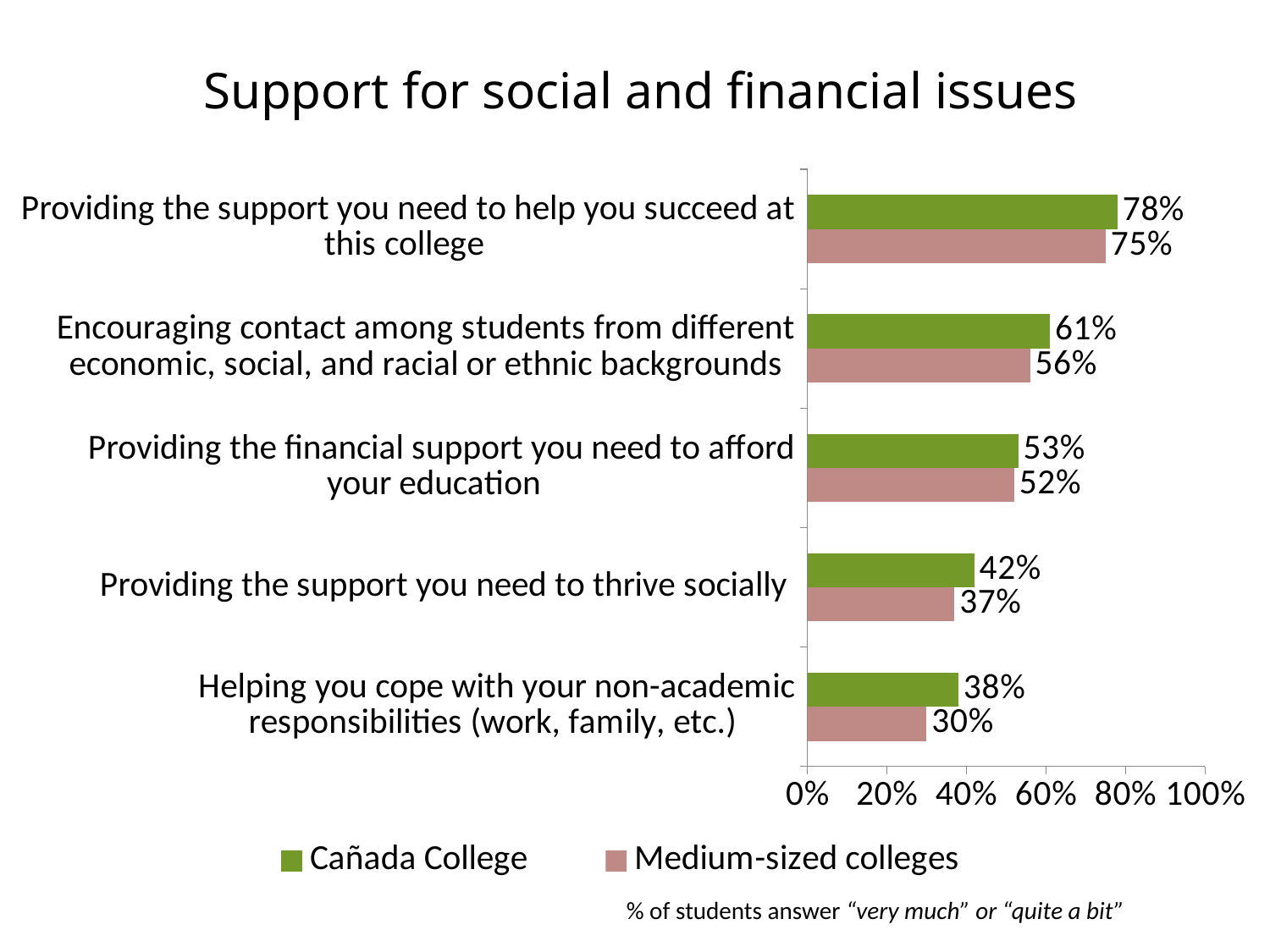
For "Providing the support you need to thrive socially", which is larger: the Cañada College value or the Medium-sized colleges value? Cañada College What percentage of Cañada College students answered "very much" or "quite a bit" for "Providing the support you need to help you succeed at this college"? 78% What is the title of the chart? Support for social and financial issues What is the difference between the Cañada College and Medium-sized colleges values for "Encouraging contact among students from different economic, social, and racial or ethnic backgrounds"? 5% Which category has the lowest Medium-sized colleges value? Helping you cope with your non-academic responsibilities (work, family, etc.) What is the difference between the Cañada College and Medium-sized colleges values for "Helping you cope with your non-academic responsibilities (work, family, etc.)"? 8% What kind of chart is shown on the slide? Bar chart What is the Medium-sized colleges value for "Helping you cope with your non-academic responsibilities (work, family, etc.)"? 30% How many categories are shown on the chart? 5 How many series does the legend list? 2 Which category has the highest Cañada College value? Providing the support you need to help you succeed at this college What is the Medium-sized colleges value for "Providing the support you need to thrive socially"? 37%